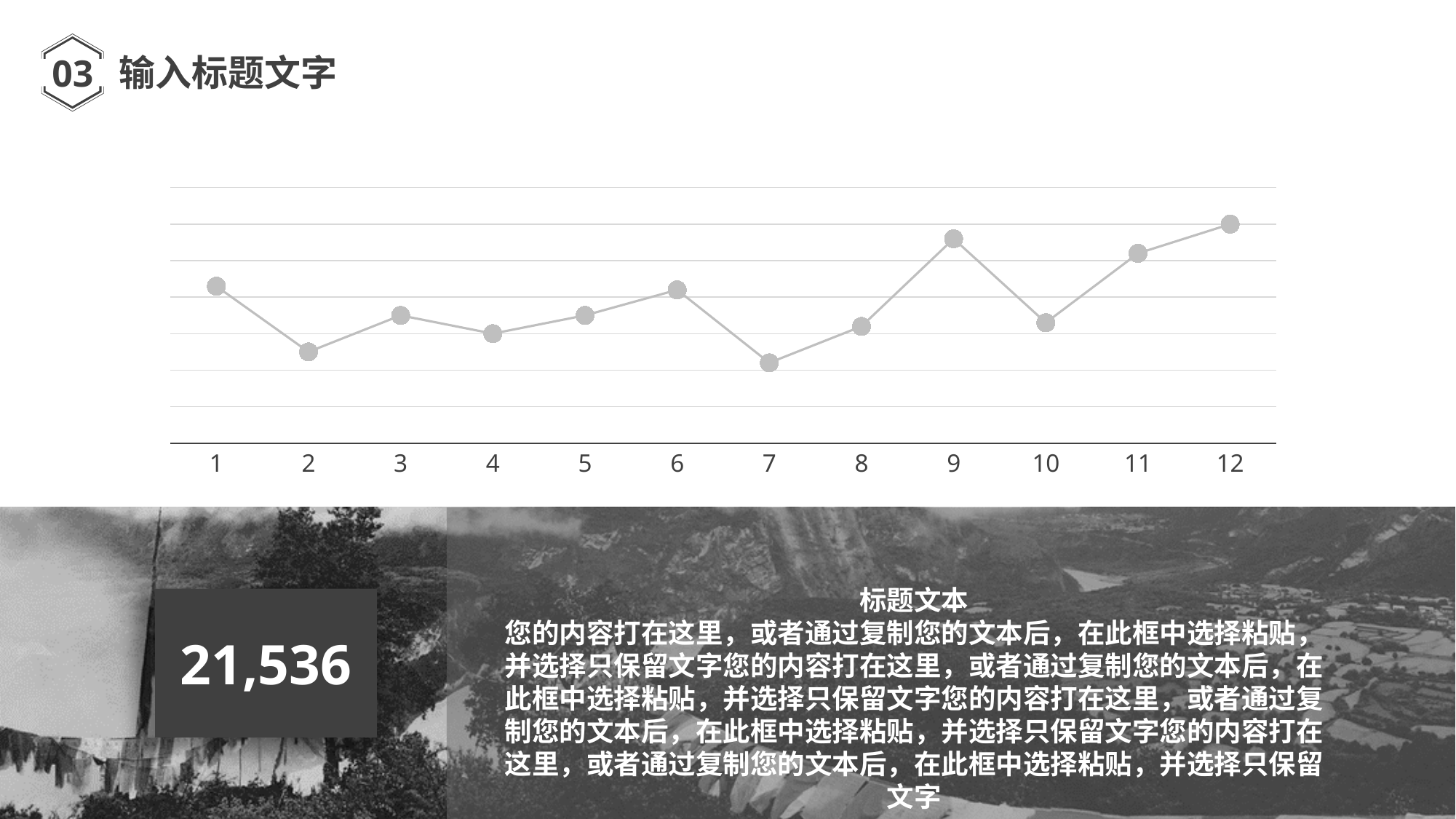
Does the line rise or fall from category 10 to category 12? rise Does the line rise or fall from category 1 to category 2? fall What are the first and last labels on the x axis of the line chart? 1 and 12 What kind of chart is shown on the slide? line chart Which is larger on the line chart, the value at 12 or the value at 1? 12 Which is larger on the line chart, the value at 1 or the value at 2? 1 Which is larger on the line chart, the value at 9 or the value at 10? 9 Does the line rise or fall from category 7 to category 9? rise How many lines (series) are plotted on the chart? 1 Which x-axis category has the highest value on the line chart? 12 How many data points are plotted on the line chart? 12